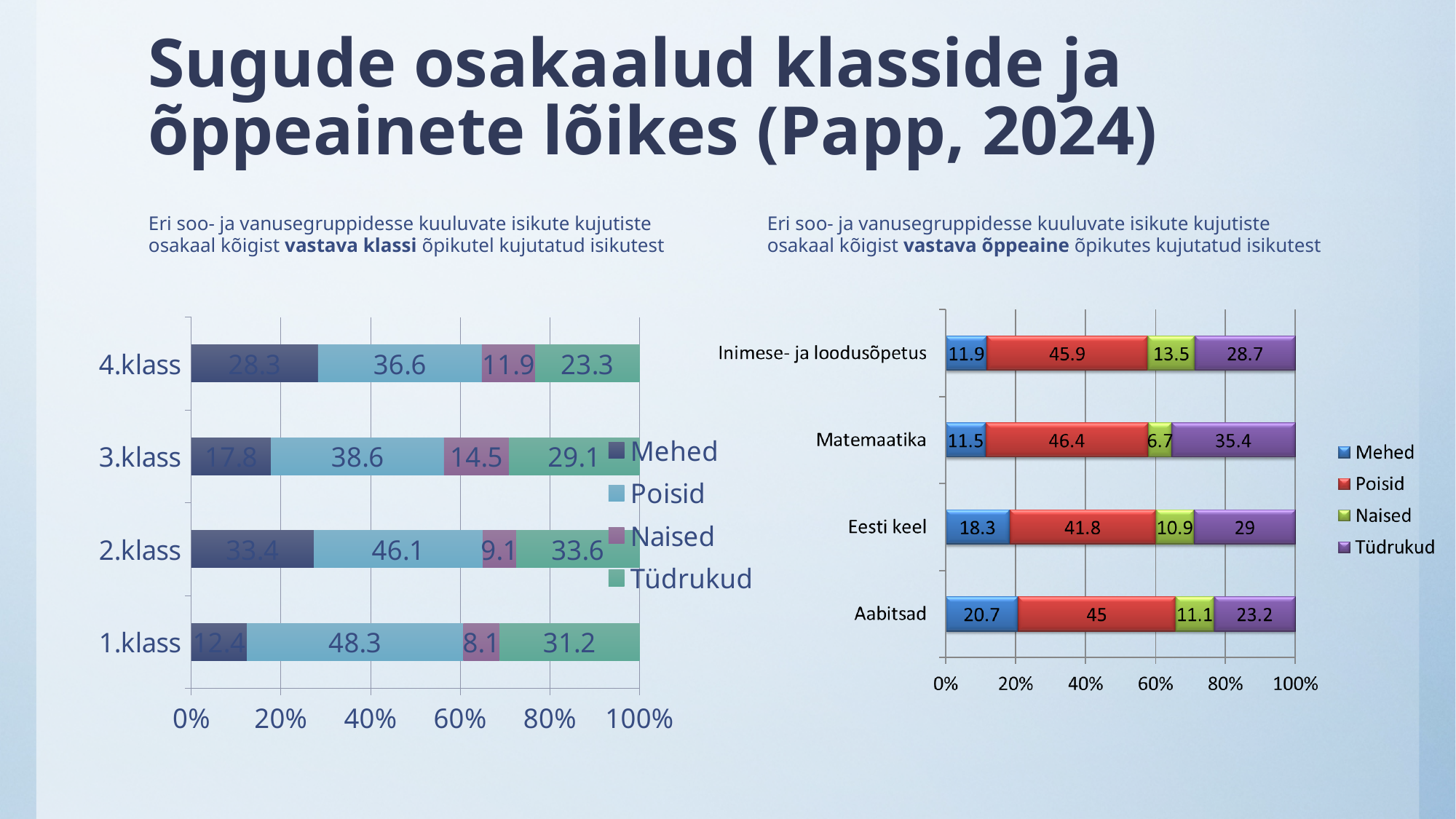
What kind of chart is the right chart (by subject)? Stacked bar chart In the right chart (by subject), how many subject categories are shown? 4 In the left chart (by class), what is the value for Poisid in 1.klass? 48.3 In the right chart (by subject), is the Mehed value larger for Aabitsad or for Inimese- ja loodusõpetus? Aabitsad In the right chart (by subject), which subject has the lowest value for Naised? Matemaatika In the right chart (by subject), what is the value for Poisid in Matemaatika? 46.4 In the left chart (by class), which class has the lowest value for Mehed? 1.klass In the left chart (by class), how many series does the legend list? 4 In the left chart (by class), what is the value for Mehed in 2.klass? 33.4 In the left chart (by class), what is the difference between the Tüdrukud values for 2.klass and 4.klass? 10.3 In the right chart (by subject), what is the value for Tüdrukud in Eesti keel? 29 In the left chart (by class), which class has the highest value for Naised? 3.klass